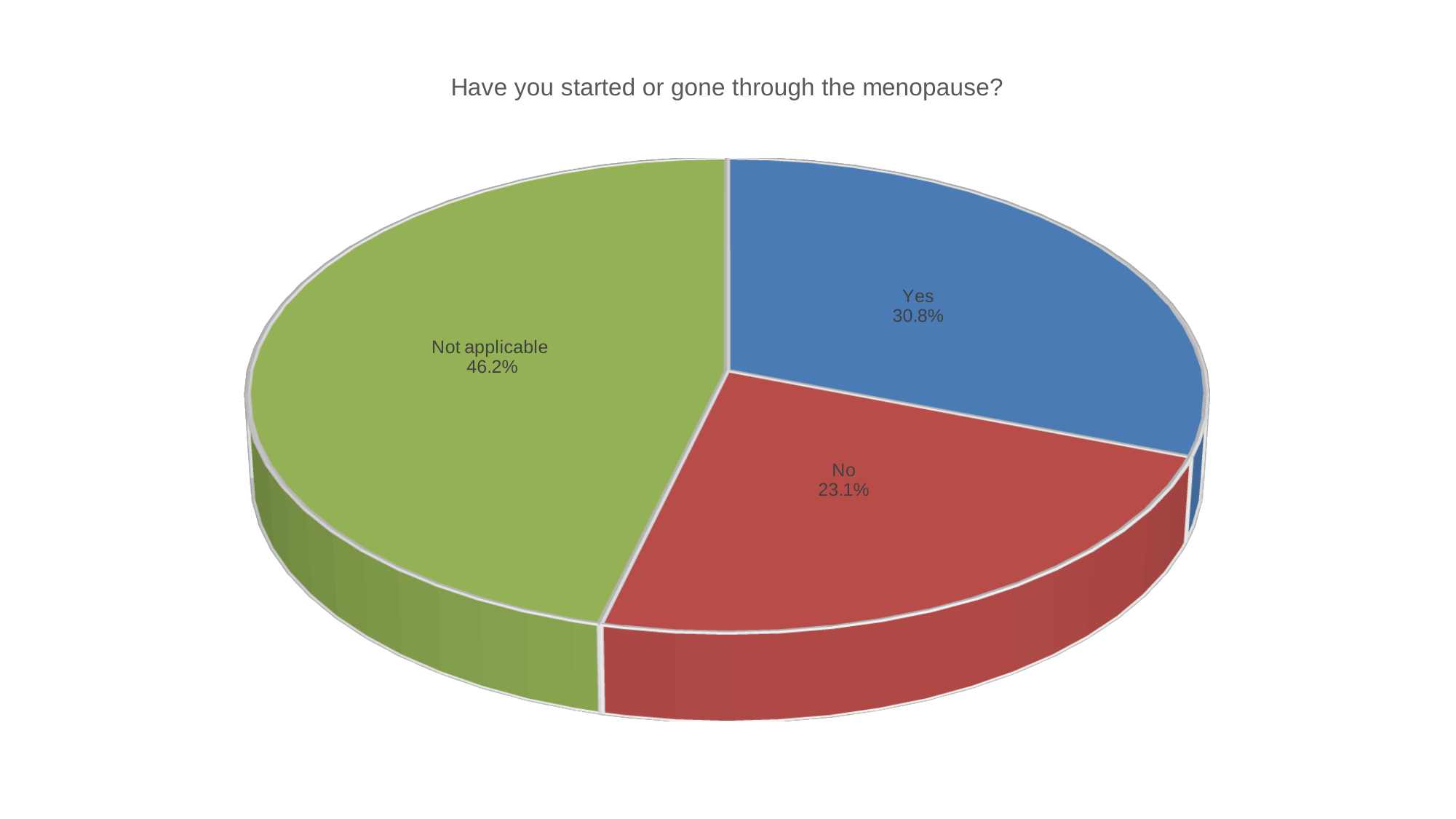
What percentage of respondents answered "Not applicable"? 46.2% What kind of chart is shown on the slide? Pie chart What is the title of the chart? Have you started or gone through the menopause? What percentage of respondents answered "No"? 23.1% How many slices does the pie chart have? 3 Which response has the largest share of the pie? Not applicable What percentage of respondents answered "Yes"? 30.8% What colour is the "Not applicable" slice? Green What is the difference in percentage points between "Not applicable" and "Yes"? 15.4 Which is larger, the share for "Yes" or the share for "No"? Yes Which response has the smallest share of the pie? No What is the difference in percentage points between "Yes" and "No"? 7.7